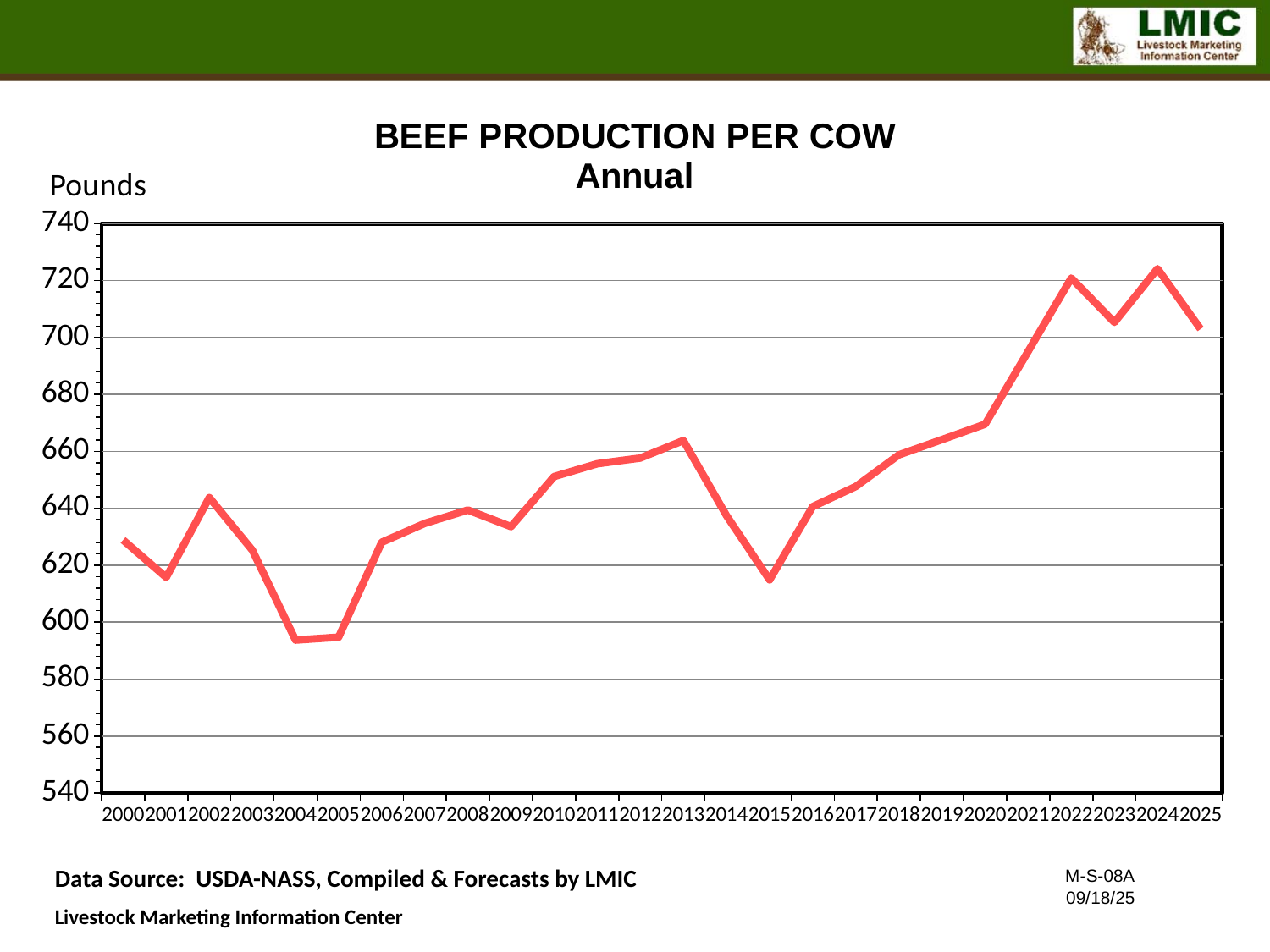
Does the value rise or fall from 2013 to 2015? fall Which year has the higher value, 2002 or 2003? 2002 Is the value for 2013 greater or less than 660? greater How many years are plotted along the x axis of the chart? 26 What kind of chart is shown on the slide? line chart Is the value for 2004 greater or less than 600? less Which year has the higher value, 2021 or 2020? 2021 What is the title of the chart? BEEF PRODUCTION PER COW Annual Does the value rise or fall from 2015 to 2022? rise What unit is shown on the vertical axis of the chart? Pounds Is the value for 2015 greater or less than 620? less